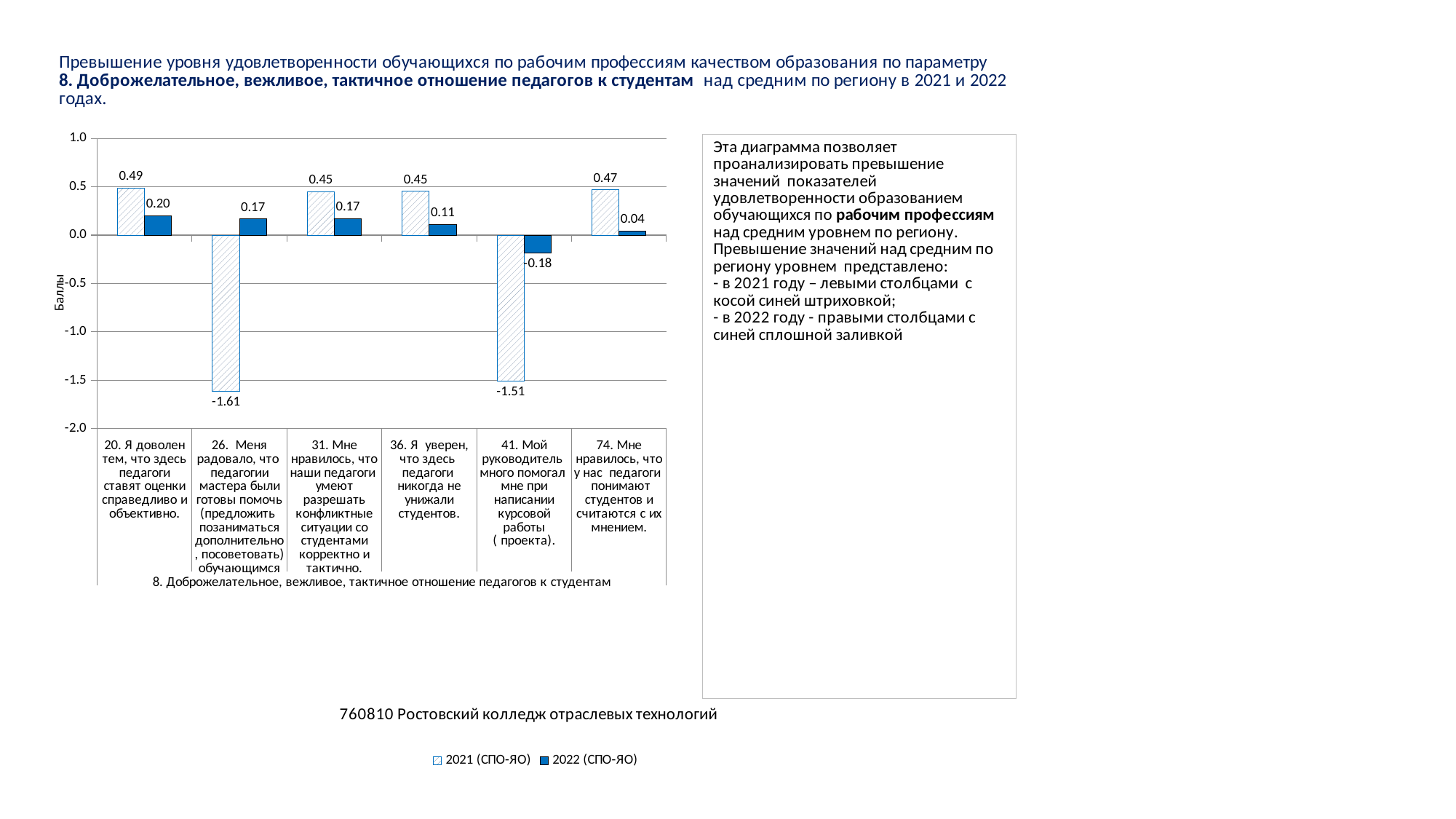
What is the 2021 (СПО-ЯО) value for category 26 (Меня радовало, что педагоги мастера были готовы помочь)? -1.61 What is the difference between the 2021 and 2022 values for category 20? 0.29 What is the 2022 (СПО-ЯО) value for category 74 (Мне нравилось, что у нас педагоги понимают студентов)? 0.04 What is the difference between the 2021 values for category 26 and category 41? 0.10 How many series does the legend list? 2 Which category has the highest 2022 (СПО-ЯО) value? 20. Я доволен тем, что здесь педагоги ставят оценки справедливо и объективно How many categories are shown on the x axis of the chart? 6 What type of chart is shown on the slide? Bar chart What is the 2022 (СПО-ЯО) value for category 41 (Мой руководитель много помогал мне при написании курсовой работы)? -0.18 Which is larger for category 36: the 2021 (СПО-ЯО) value or the 2022 (СПО-ЯО) value? 2021 (СПО-ЯО) Which category has the lowest 2021 (СПО-ЯО) value? 26. Меня радовало, что педагоги мастера были готовы помочь What is the 2021 (СПО-ЯО) value for category 20 (Я доволен тем, что здесь педагоги ставят оценки справедливо и объективно)? 0.49